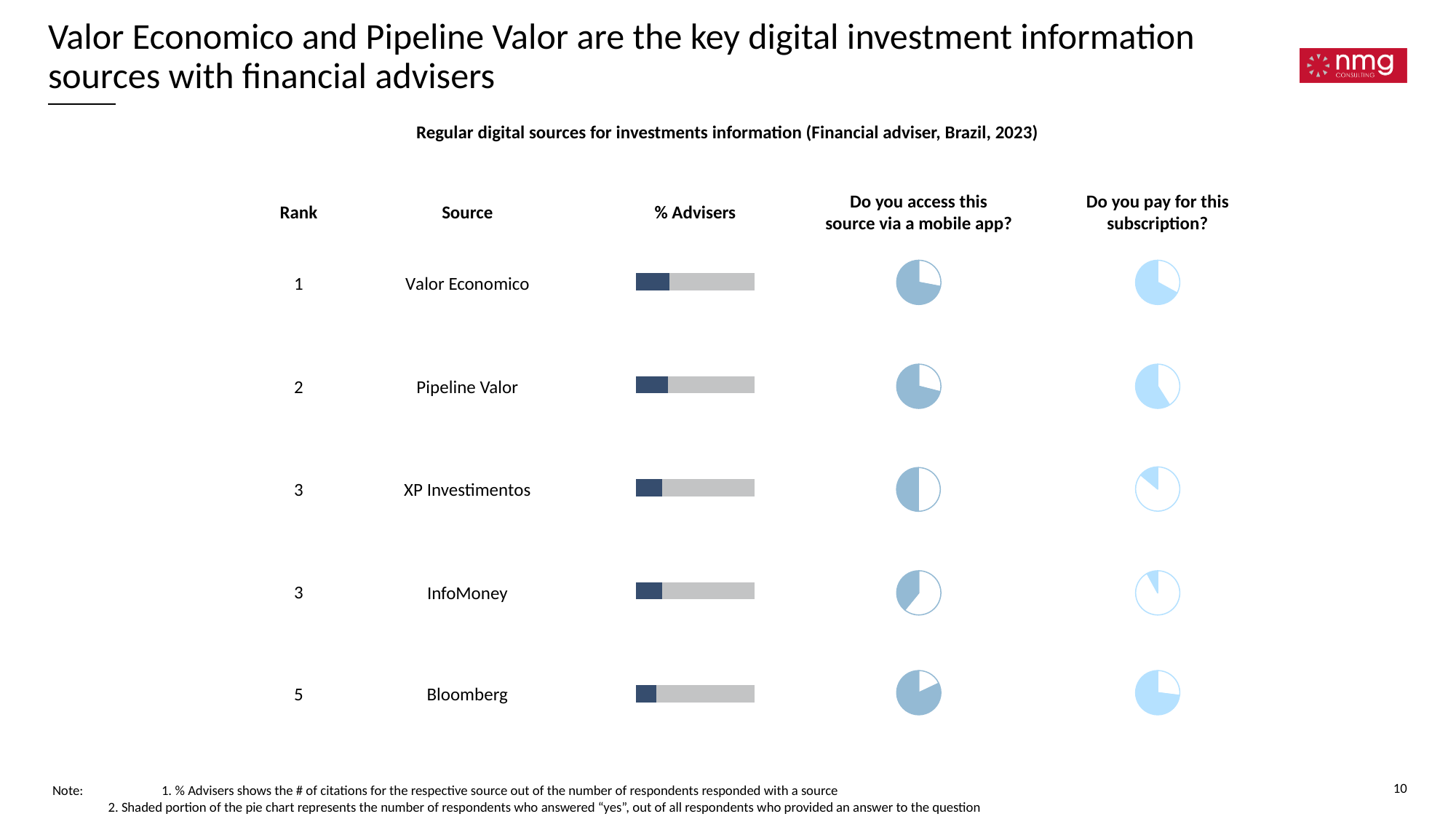
What rank is shown for Bloomberg? 5 What kind of chart is used in the '% Advisers' column? Bar chart What is the title of the chart on the slide? Regular digital sources for investments information (Financial adviser, Brazil, 2023) Which source is ranked 1? Valor Economico What kind of chart is used in the 'Do you access this source via a mobile app?' column? Pie chart Which source has the shortest '% Advisers' bar? Bloomberg Which has the larger '% Advisers' bar, XP Investimentos or Bloomberg? XP Investimentos In the 'Do you access this source via a mobile app?' column, which has the larger shaded share, Bloomberg or InfoMoney? Bloomberg How many sources are listed in the table? 5 What rank is shown for InfoMoney? 3 In the 'Do you pay for this subscription?' column, which has the larger shaded share, Valor Economico or XP Investimentos? Valor Economico In the 'Do you pay for this subscription?' column, which source has the smallest shaded share? InfoMoney